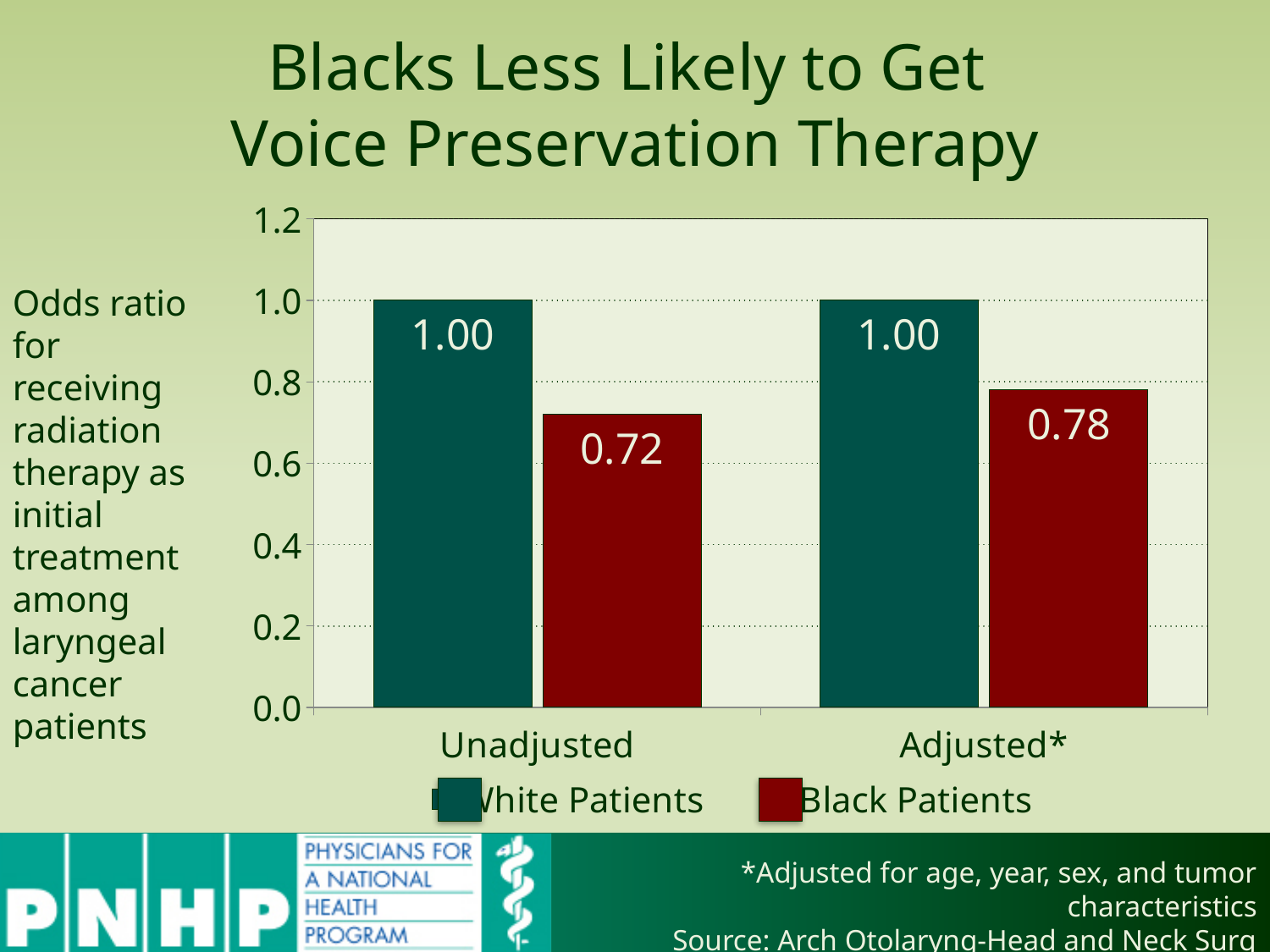
How many series does the legend list? 2 What is the odds ratio for Black Patients in the Adjusted* category? 0.78 What is the odds ratio for White Patients in the Unadjusted category? 1.00 What is the difference between the White Patients and Black Patients values in the Unadjusted category? 0.28 What kind of chart is shown on the slide? bar chart Which is larger for Black Patients: the Unadjusted value or the Adjusted* value? Adjusted* Is the value for Black Patients in the Unadjusted category greater or less than 0.8? less How many categories are shown on the x axis? 2 What is the odds ratio for Black Patients in the Unadjusted category? 0.72 What is the odds ratio for White Patients in the Adjusted* category? 1.00 What colour are the bars for Black Patients? dark red What is the difference between the White Patients and Black Patients values in the Adjusted* category? 0.22